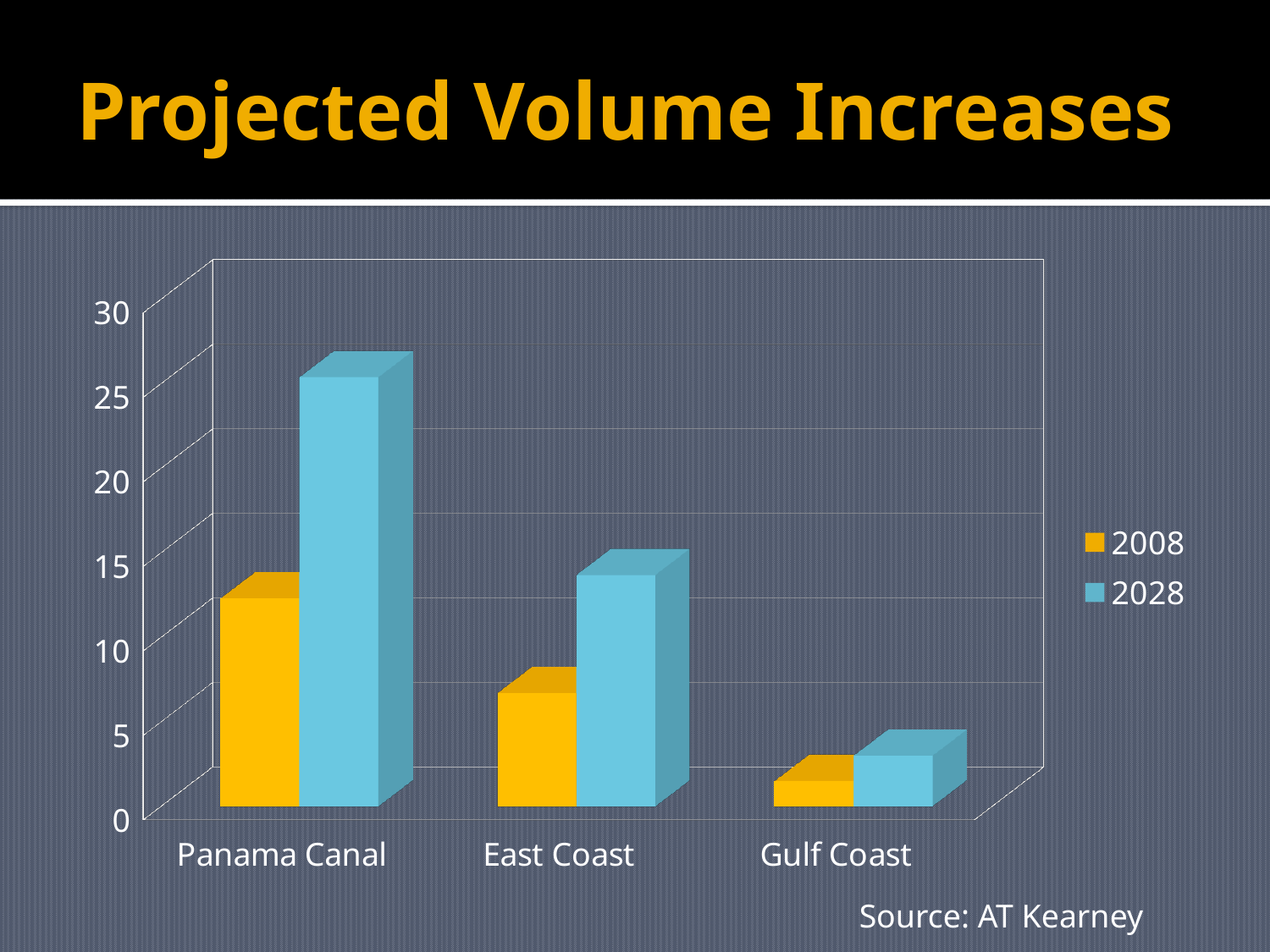
What kind of chart is shown on the slide? bar chart Do the 2028 values rise or fall moving from Panama Canal to Gulf Coast along the x axis? fall Which is larger: the 2028 value for East Coast or the 2028 value for Gulf Coast? East Coast Is the 2008 value for Panama Canal greater or less than 10? greater Is the 2028 value for Gulf Coast greater or less than 5? less How many categories are shown on the x axis of the chart? 3 Is the 2008 value for East Coast greater or less than 10? less Which category has the highest value for the 2028 series? Panama Canal How many series does the chart's legend list? 2 What is the title of the chart on the slide? Projected Volume Increases Which category has the lowest value for the 2008 series? Gulf Coast